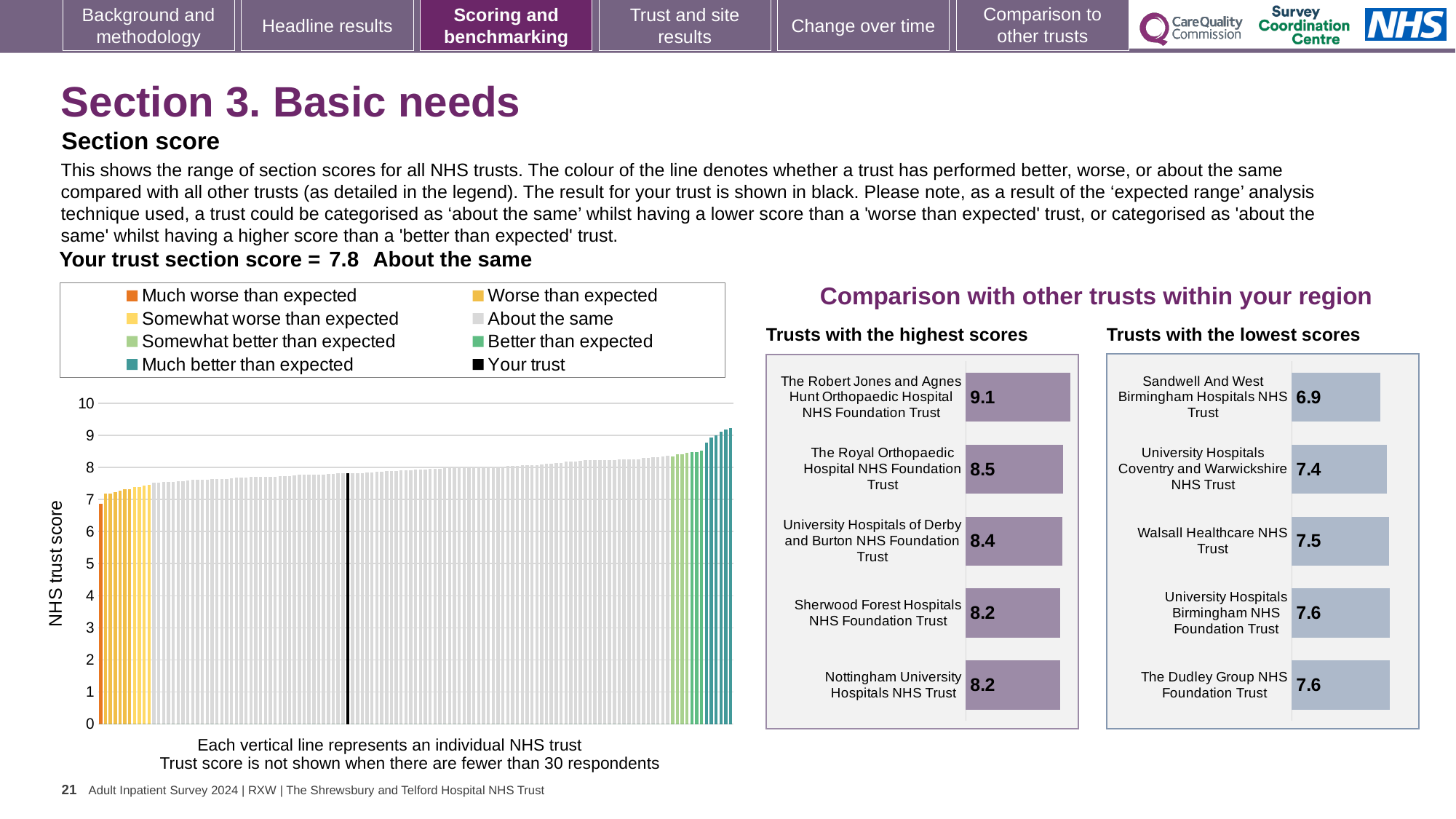
What kind of chart is the main chart on the left showing the range of section scores for all NHS trusts? Bar chart In the 'Trusts with the highest scores' chart, what is the score for The Robert Jones and Agnes Hunt Orthopaedic Hospital NHS Foundation Trust? 9.1 In the 'Trusts with the lowest scores' chart, which trust has the lowest score? Sandwell And West Birmingham Hospitals NHS Trust In the 'Trusts with the highest scores' chart, what is the difference between the scores of The Robert Jones and Agnes Hunt Orthopaedic Hospital NHS Foundation Trust and The Royal Orthopaedic Hospital NHS Foundation Trust? 0.6 In the 'Trusts with the lowest scores' chart, what is the score for Sandwell And West Birmingham Hospitals NHS Trust? 6.9 In the 'Trusts with the highest scores' chart, what is the score for University Hospitals of Derby and Burton NHS Foundation Trust? 8.4 How many entries does the legend of the main chart on the left list? 8 In the 'Trusts with the highest scores' chart, which trust has the highest score? The Robert Jones and Agnes Hunt Orthopaedic Hospital NHS Foundation Trust In the 'Trusts with the lowest scores' chart, what is the score for Walsall Healthcare NHS Trust? 7.5 In the main chart on the left showing the range of section scores, what is the section score for your trust? 7.8 In the 'Trusts with the lowest scores' chart, which has the larger score: University Hospitals Coventry and Warwickshire NHS Trust or Walsall Healthcare NHS Trust? Walsall Healthcare NHS Trust How many trusts are shown in the 'Trusts with the highest scores' chart? 5